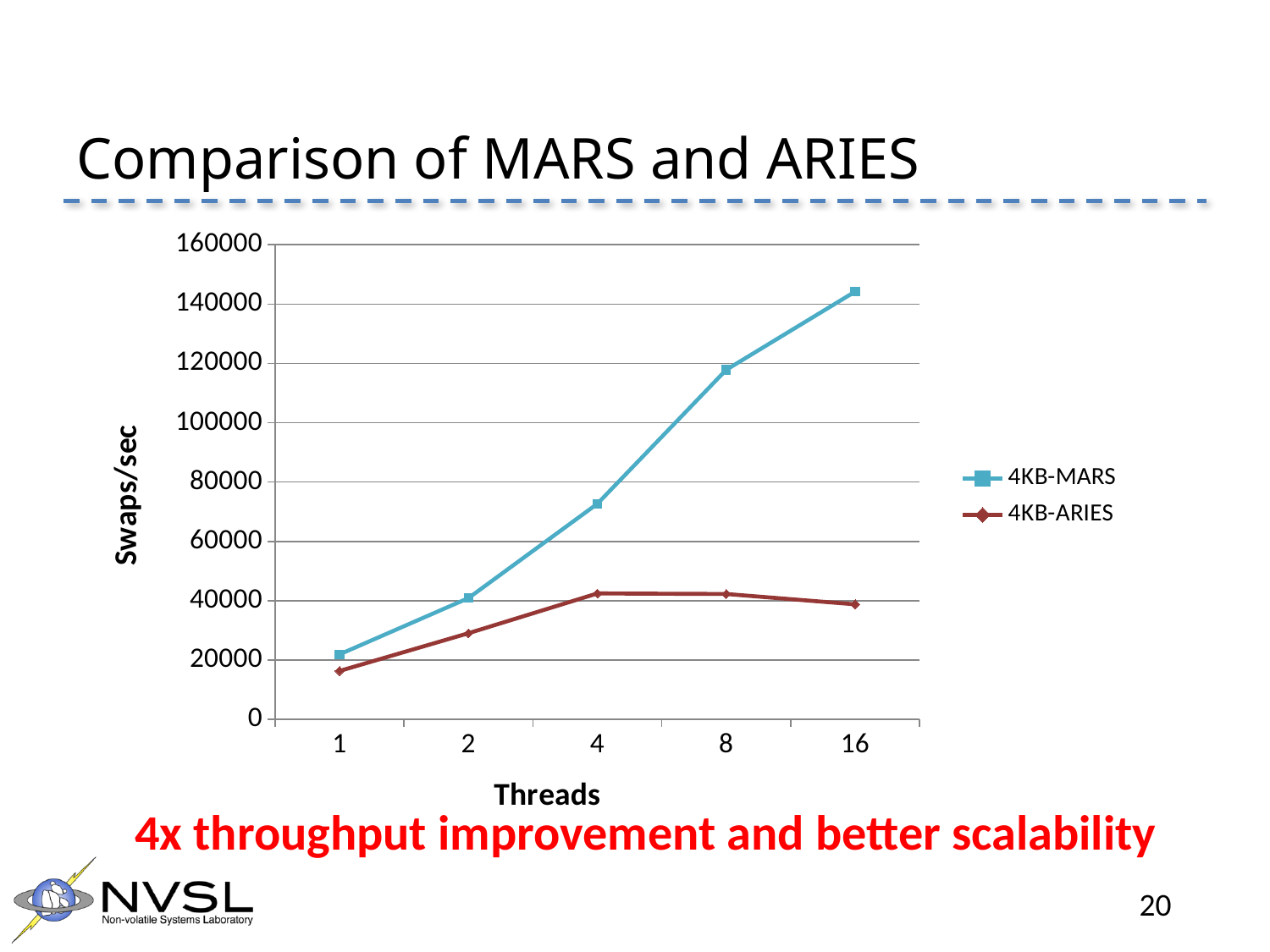
At which thread count is 4KB-ARIES lowest? 1 How many thread counts are plotted along the x axis? 5 At 8 threads, which series has the higher swaps/sec, 4KB-MARS or 4KB-ARIES? 4KB-MARS What is the label on the y axis of the chart? Swaps/sec At which thread count does 4KB-MARS reach its highest swaps/sec? 16 What kind of chart is shown on the slide? line chart Is the value for 4KB-MARS at 8 threads greater or less than 100000? greater How many series does the legend list? 2 At which thread count is 4KB-MARS lowest? 1 Does the 4KB-MARS series rise or fall as the number of threads increases? rise Is the value for 4KB-MARS at 4 threads greater or less than 80000? less Is the value for 4KB-ARIES at 2 threads greater or less than 40000? less